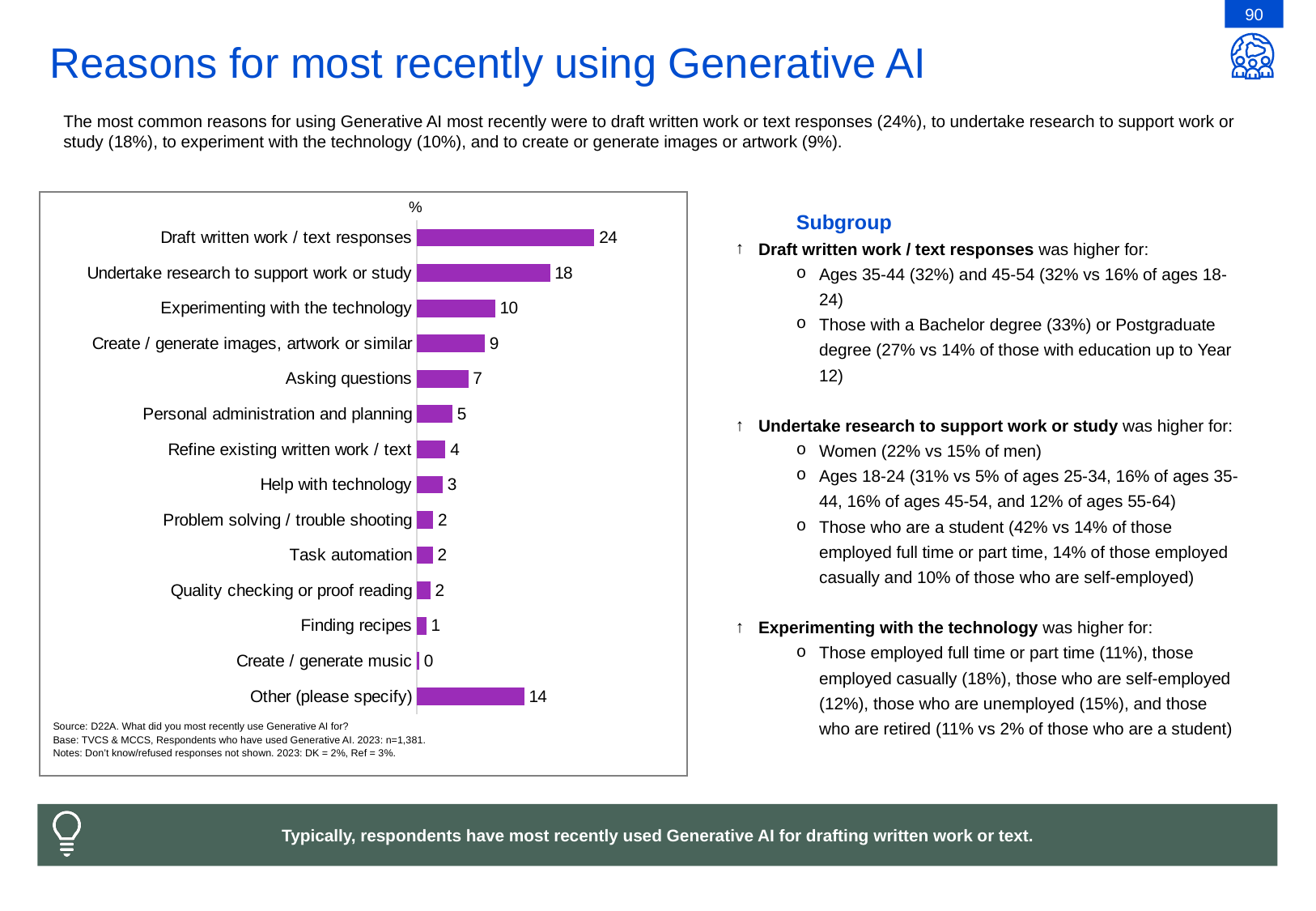
Which is larger, Experimenting with the technology or Create / generate images, artwork or similar? Experimenting with the technology What is the difference between Other (please specify) and Experimenting with the technology? 4 What is the value for Undertake research to support work or study? 18 Which category has the highest value? Draft written work / text responses What is the value for Draft written work / text responses? 24 What is the value for Asking questions? 7 Which category has the lowest value? Create / generate music What is the value for Other (please specify)? 14 What colour are the bars in the chart? Purple How many categories are shown in the chart? 14 What is the difference between Draft written work / text responses and Undertake research to support work or study? 6 What kind of chart is shown on the slide? Bar chart